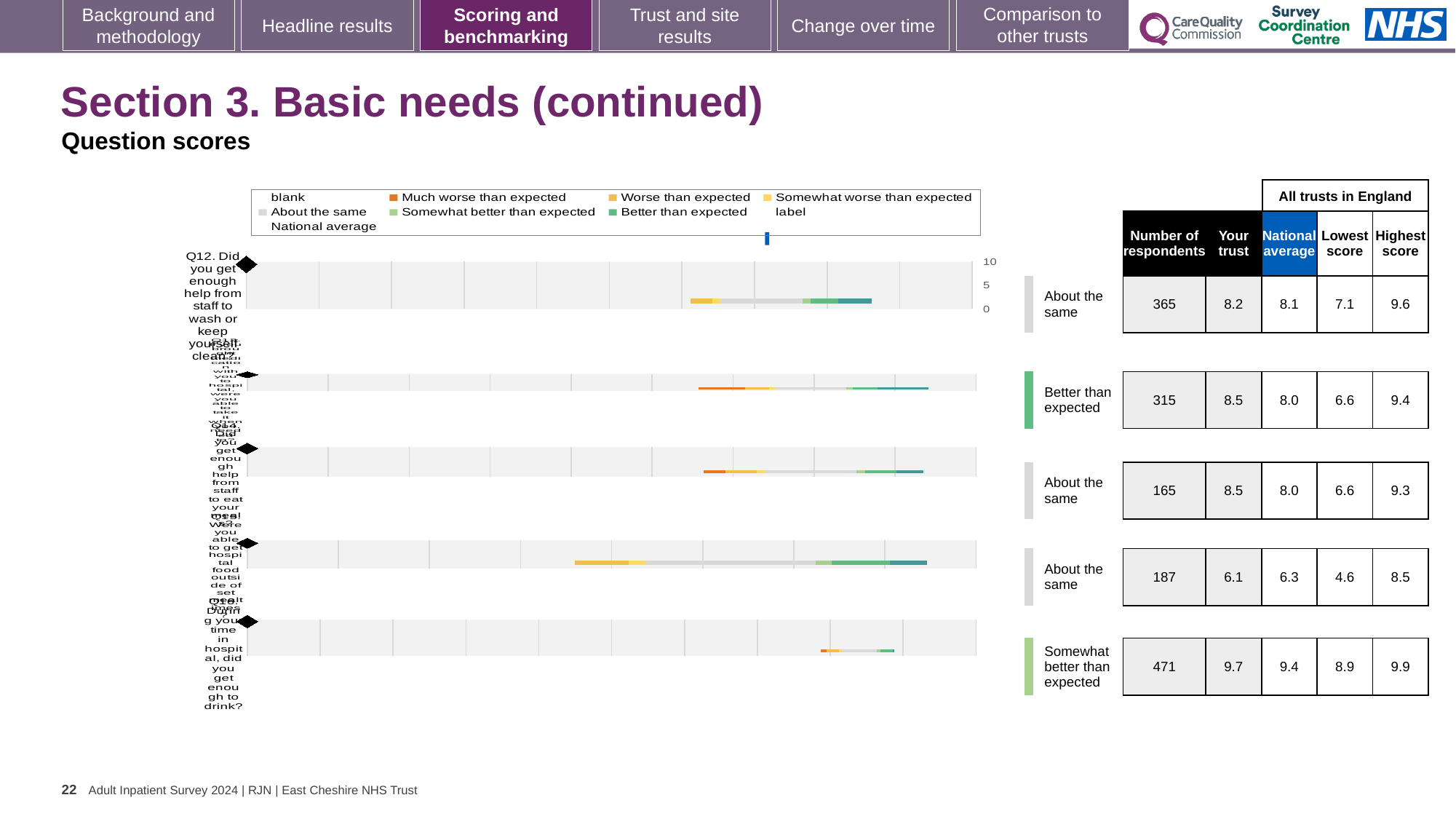
For the fourth question row, which is larger: the 'Your trust' score or the national average? National average How many respondents answered Q12 (help from staff to wash or keep yourself clean)? 365 What is the 'Your trust' score for Q12 (Did you get enough help from staff to wash or keep yourself clean?)? 8.2 What kind of chart is shown on the slide? bar chart How many of the five question rows are rated 'About the same'? 3 What is the lowest 'Your trust' score among the five questions shown? 6.1 Which benchmark category is Q12 (help from staff to wash or keep yourself clean) rated as? About the same What is the national average score for Q12 (help from staff to wash or keep yourself clean)? 8.1 What is the highest 'Your trust' score among the five questions shown? 9.7 What is the highest score across all trusts in England for Q12 (help from staff to wash or keep yourself clean)? 9.6 How many survey questions are plotted as rows in the chart? 5 For Q12 (help from staff to wash or keep yourself clean), what is the difference between the 'Your trust' score and the national average? 0.1